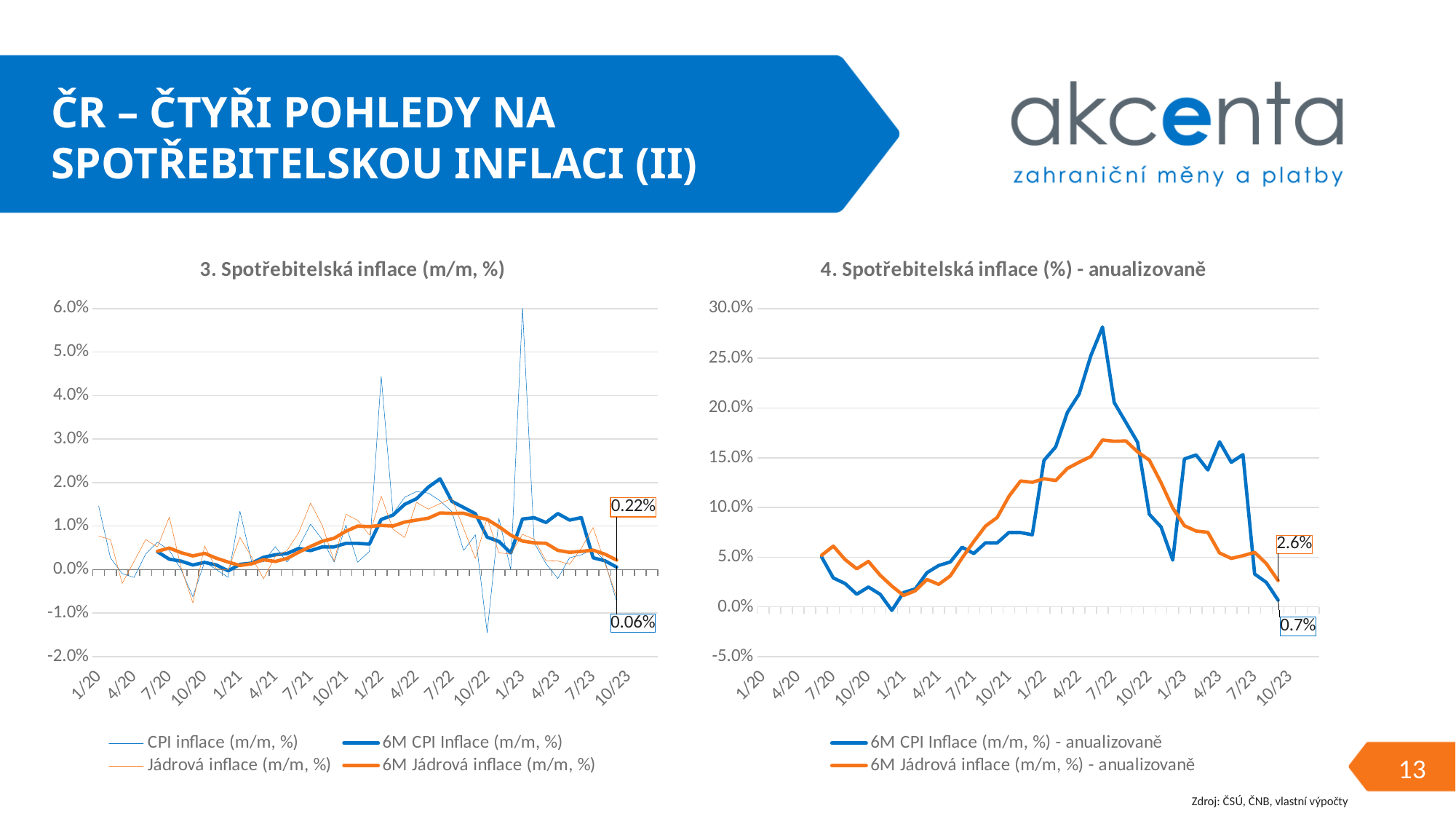
In chart "4. Spotřebitelská inflace (%) - anualizovaně", does the 6M Jádrová inflace (m/m, %) - anualizovaně series rise or fall between 7/22 and 10/23? fall In chart "4. Spotřebitelská inflace (%) - anualizovaně", what is the difference between the labelled final values 2.6% and 0.7%? 1.9 percentage points In chart "3. Spotřebitelská inflace (m/m, %)", what is the difference between the labelled final values 0.22% and 0.06%? 0.16 percentage points In chart "4. Spotřebitelská inflace (%) - anualizovaně", what is the labelled final value of the 6M CPI Inflace (m/m, %) - anualizovaně series? 0.7% In chart "4. Spotřebitelská inflace (%) - anualizovaně", what is the labelled final value of the 6M Jádrová inflace (m/m, %) - anualizovaně series? 2.6% In chart "3. Spotřebitelská inflace (m/m, %)", what is the labelled final value of the 6M Jádrová inflace (m/m, %) series? 0.22% In chart "4. Spotřebitelská inflace (%) - anualizovaně", which series has the higher labelled final value, 6M CPI Inflace or 6M Jádrová inflace? 6M Jádrová inflace (m/m, %) - anualizovaně In chart "3. Spotřebitelská inflace (m/m, %)", what is the labelled final value of the 6M CPI Inflace (m/m, %) series? 0.06% How many series does the legend of chart "4. Spotřebitelská inflace (%) - anualizovaně" list? 2 What kind of chart is "3. Spotřebitelská inflace (m/m, %)"? line chart How many series does the legend of chart "3. Spotřebitelská inflace (m/m, %)" list? 4 In chart "4. Spotřebitelská inflace (%) - anualizovaně", is the peak value of the 6M CPI Inflace (m/m, %) - anualizovaně series greater or less than 25.0%? greater